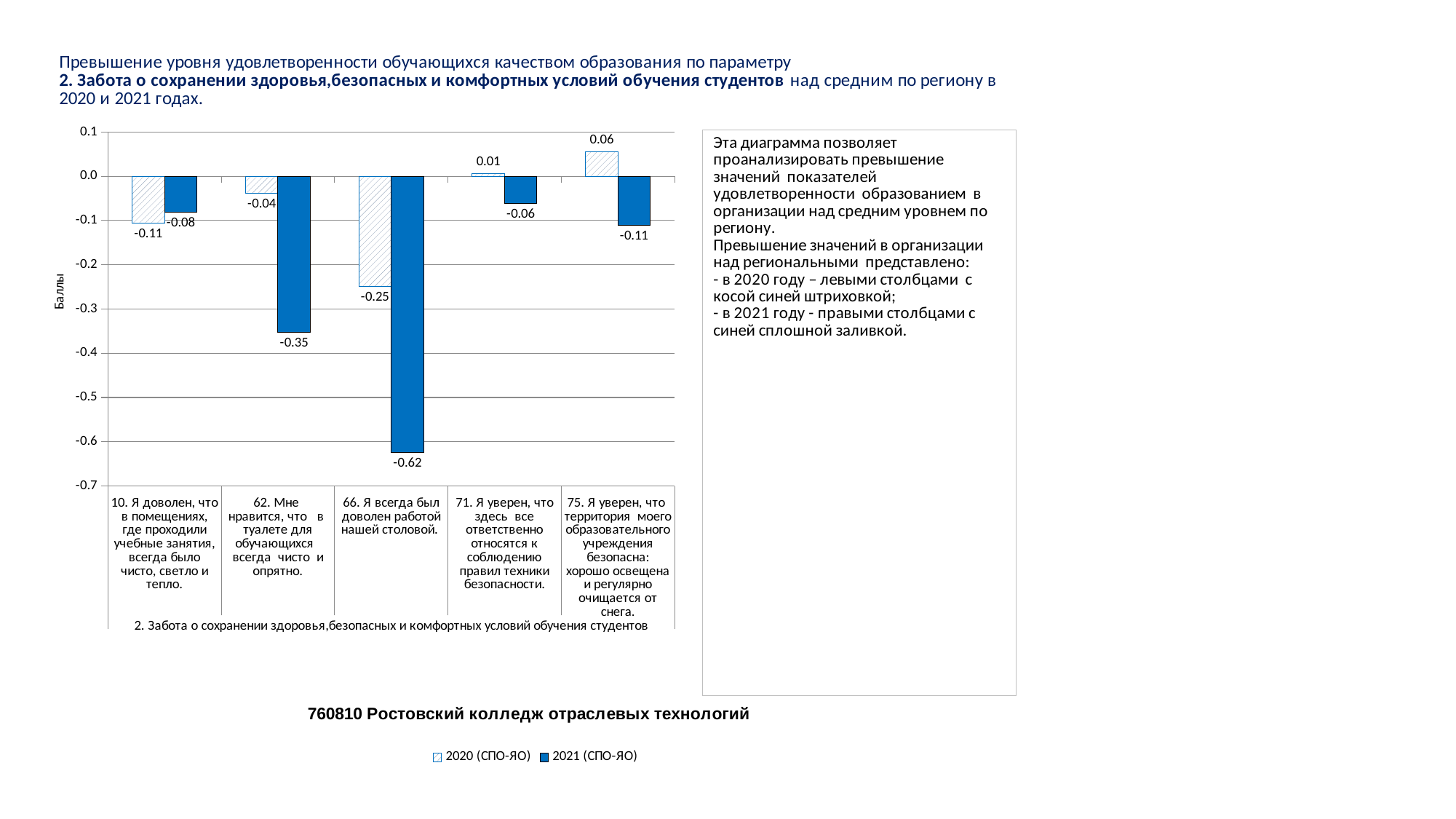
Which category has the highest 2020 (СПО-ЯО) value? 75. Я уверен, что территория моего образовательного учреждения безопасна For question 10, which is larger: the 2020 (СПО-ЯО) value or the 2021 (СПО-ЯО) value? 2021 (СПО-ЯО) What is the 2021 (СПО-ЯО) value for question 62 (Мне нравится, что в туалете для обучающихся всегда чисто и опрятно)? -0.35 How many series does the legend list? 2 How many categories (questions) are shown on the x axis? 5 What is the 2020 (СПО-ЯО) value for question 75 (Я уверен, что территория моего образовательного учреждения безопасна)? 0.06 What is the difference between the 2020 and 2021 values for question 66? 0.37 What type of chart is shown on the slide? bar chart What is the label of the y axis? Баллы What is the 2021 (СПО-ЯО) value for question 66 (Я всегда был доволен работой нашей столовой)? -0.62 Which category has the lowest 2021 (СПО-ЯО) value? 66. Я всегда был доволен работой нашей столовой. What is the 2020 (СПО-ЯО) value for question 71 (Я уверен, что здесь все ответственно относятся к соблюдению правил техники безопасности)? 0.01